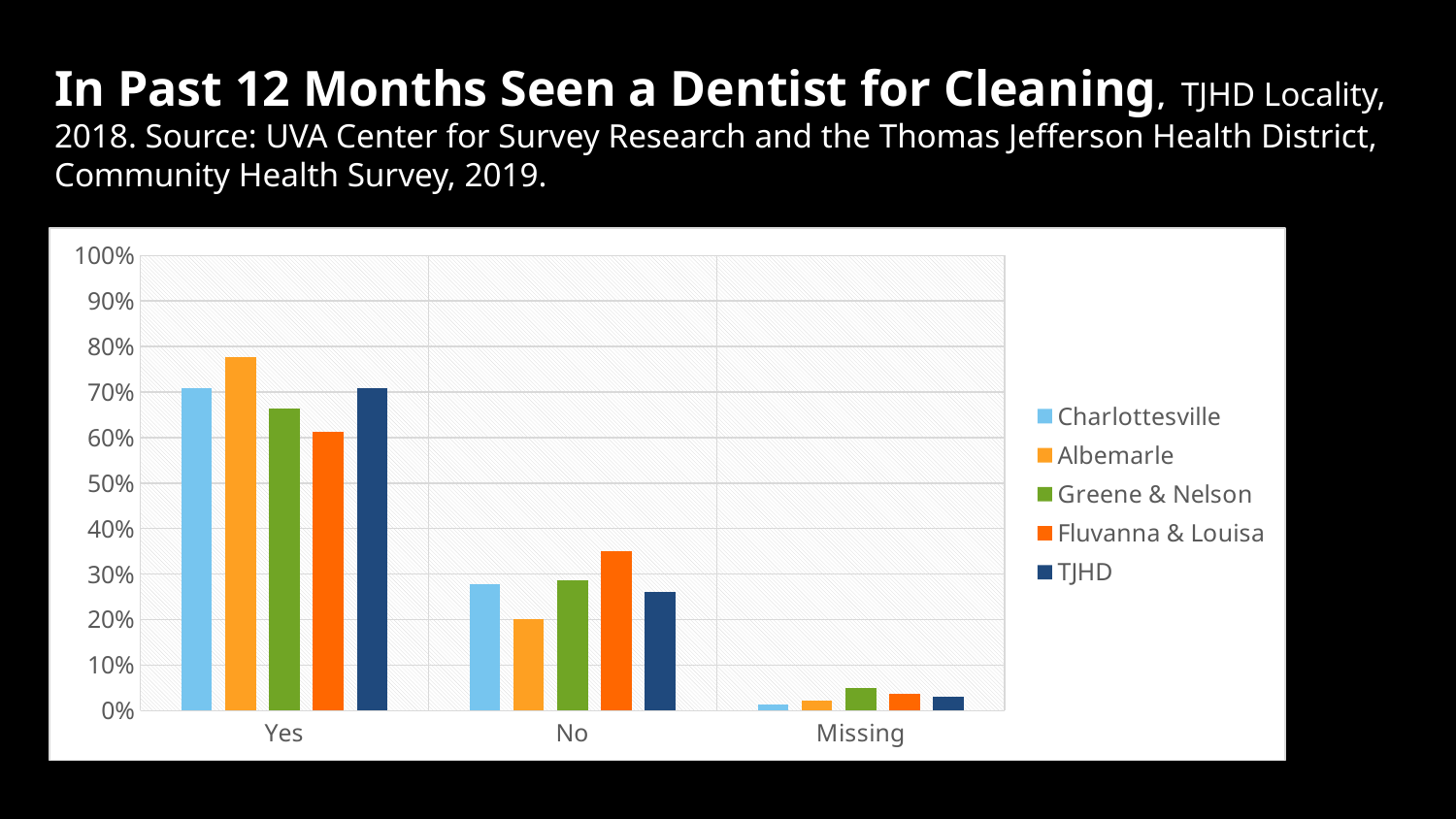
In the Yes category, which is larger: Albemarle or Greene & Nelson? Albemarle Which locality has the lowest value in the Yes category? Fluvanna & Louisa Is the value for Albemarle in the Yes category greater or less than 70%? greater What kind of chart is shown on the slide? bar chart How many categories are shown on the x axis? 3 How many series does the legend list? 5 Which locality has the highest value in the No category? Fluvanna & Louisa Which legend entry is shown in dark blue? TJHD Is the value for Albemarle in the No category greater or less than 25%? less Which locality has the highest value in the Yes category? Albemarle Is the value for Fluvanna & Louisa in the No category greater or less than 30%? greater Which locality has the lowest value in the No category? Albemarle